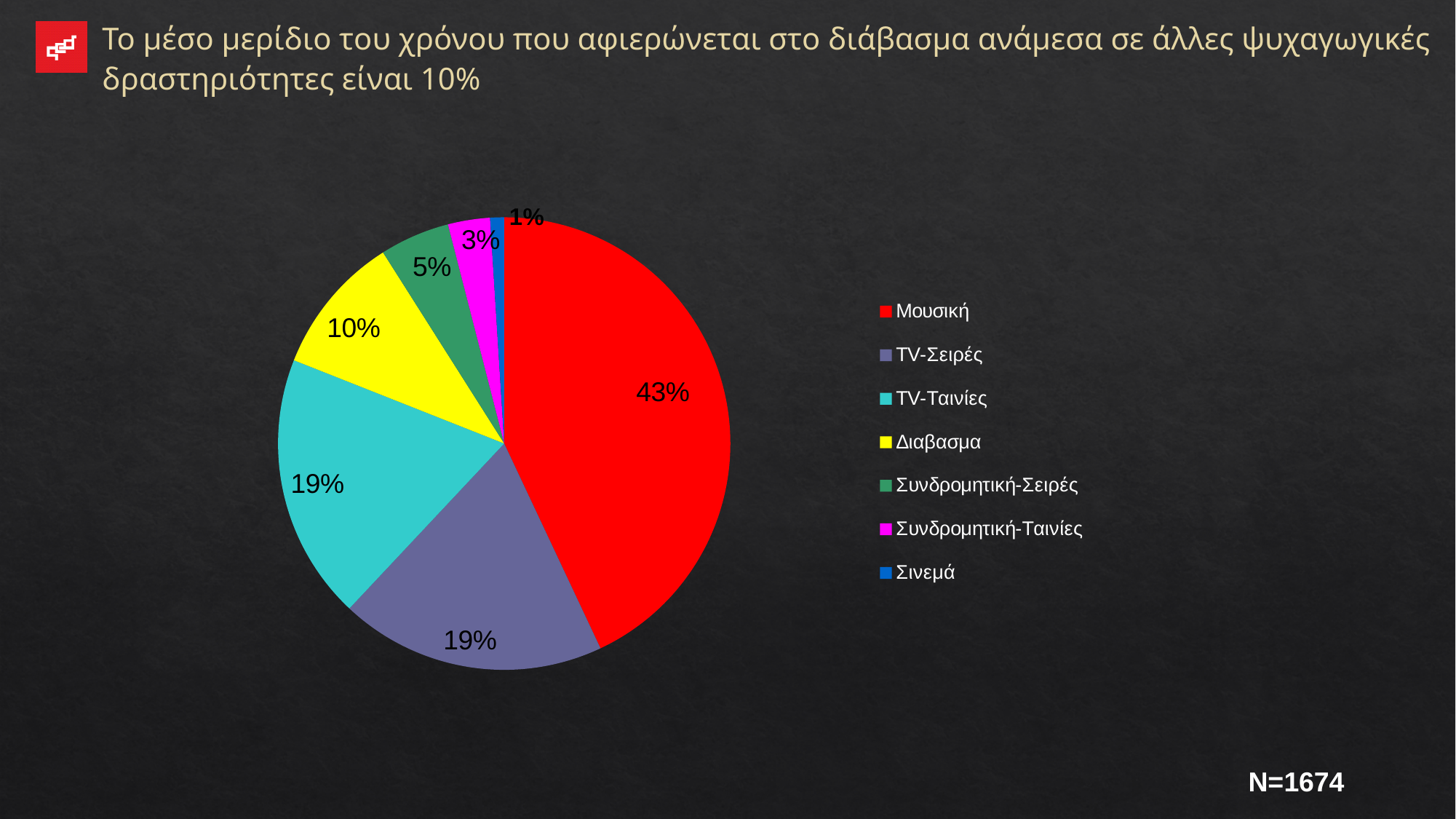
What is the value for Συνδρομητική-Ταινίες? 3% How many categories does the legend list? 7 What share of the pie does Μουσική have? 43% Which category has the smallest slice of the pie? Σινεμά What colour is the slice for TV-Ταινίες? cyan Which category has the largest slice of the pie? Μουσική Which is larger, the value for Διαβασμα or the value for Συνδρομητική-Σειρές? Διαβασμα What is the difference between the values for Μουσική and TV-Σειρές? 24% What is the value for Διαβασμα? 10% What kind of chart is shown on the slide? pie chart What is the value for Συνδρομητική-Σειρές? 5% What is the value for Σινεμά? 1%